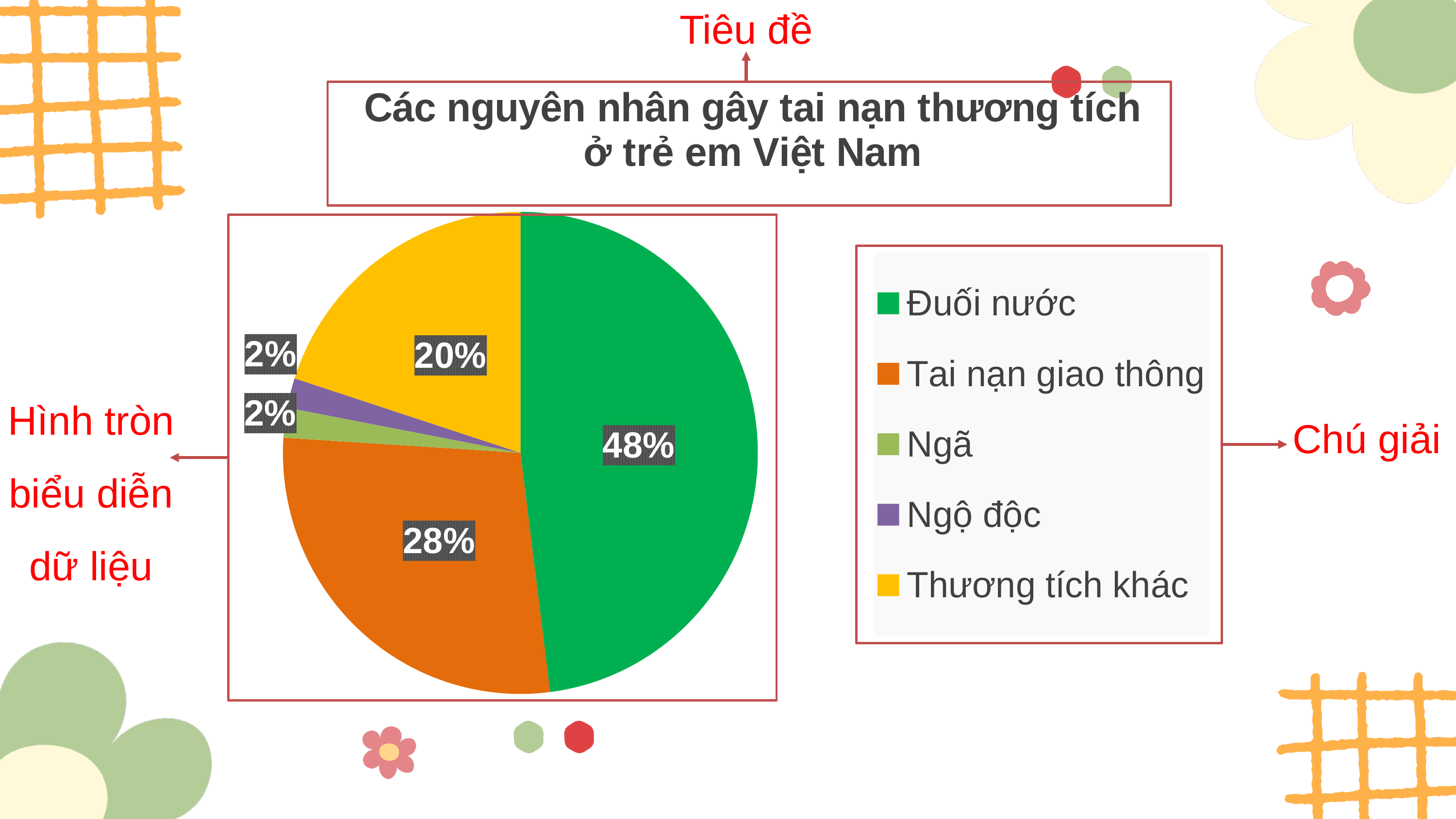
What percentage of the pie is Thương tích khác? 20% What percentage of the pie is Đuối nước? 48% Which category has the largest slice of the pie? Đuối nước What colour is the Thương tích khác slice? Yellow What percentage of the pie is Tai nạn giao thông? 28% What is the difference between the Đuối nước and Tai nạn giao thông shares? 20% What percentage of the pie is Ngộ độc? 2% What percentage of the pie is Ngã? 2% How many categories does the legend list? 5 What kind of chart is shown on the slide? Pie chart Which is larger, the share for Tai nạn giao thông or the share for Thương tích khác? Tai nạn giao thông What is the title of the chart? Các nguyên nhân gây tai nạn thương tích ở trẻ em Việt Nam